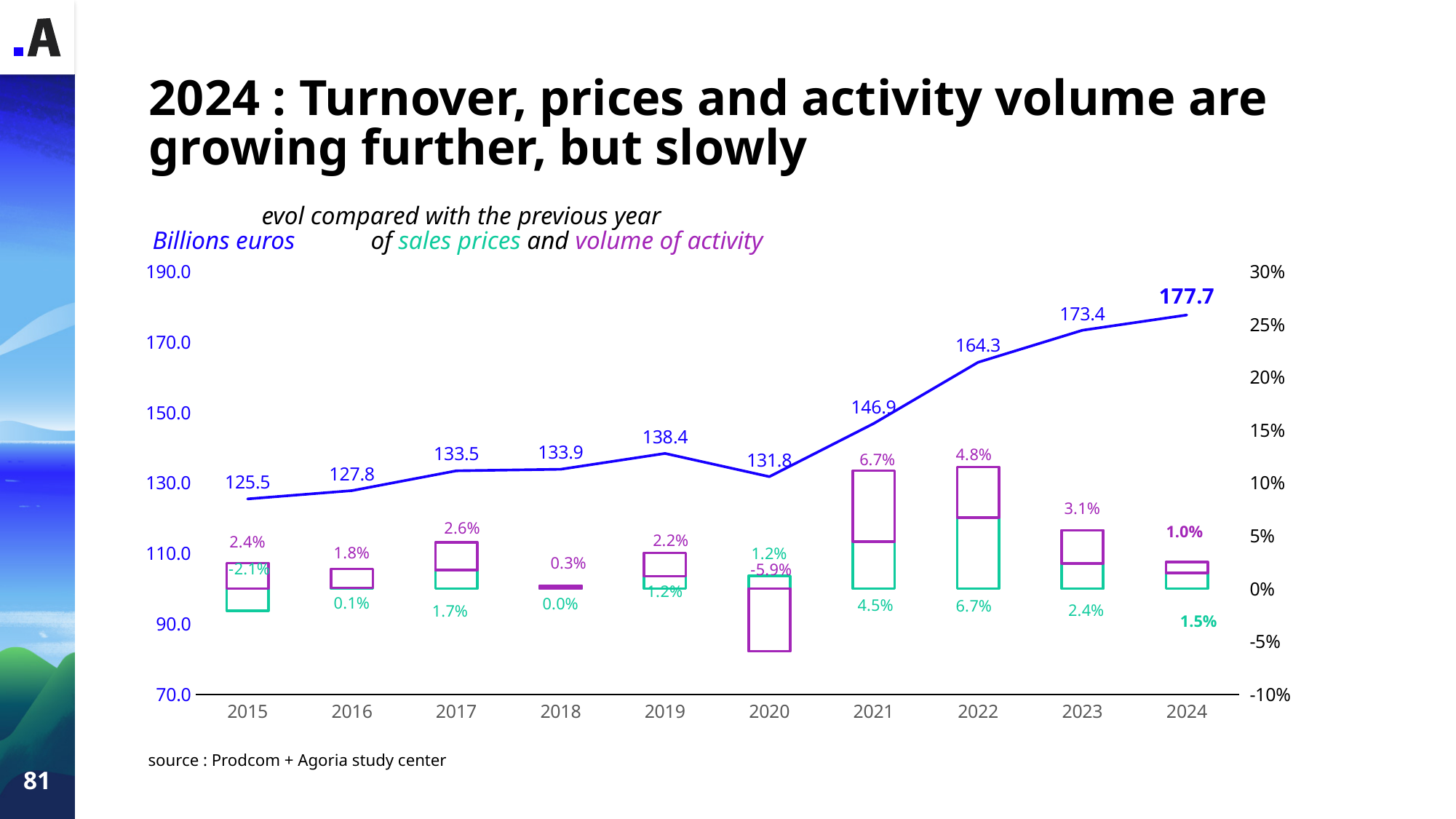
Which year has the lowest turnover in billions euros? 2015 What is the turnover in billions euros for 2024? 177.7 What is the source cited below the chart? Prodcom + Agoria study center In 2021, which is larger: the sales prices evolution or the volume of activity evolution? volume of activity How many years are shown on the x axis? 10 Does the turnover line rise or fall from 2020 to 2024? rise Which year has the lowest volume of activity evolution? 2020 What is the difference in turnover between 2024 and 2023? 4.3 Which year has the highest turnover in billions euros? 2024 What is the volume of activity evolution for 2021? 6.7% What is the volume of activity evolution for 2020? -5.9% What is the sales prices evolution for 2022? 6.7%